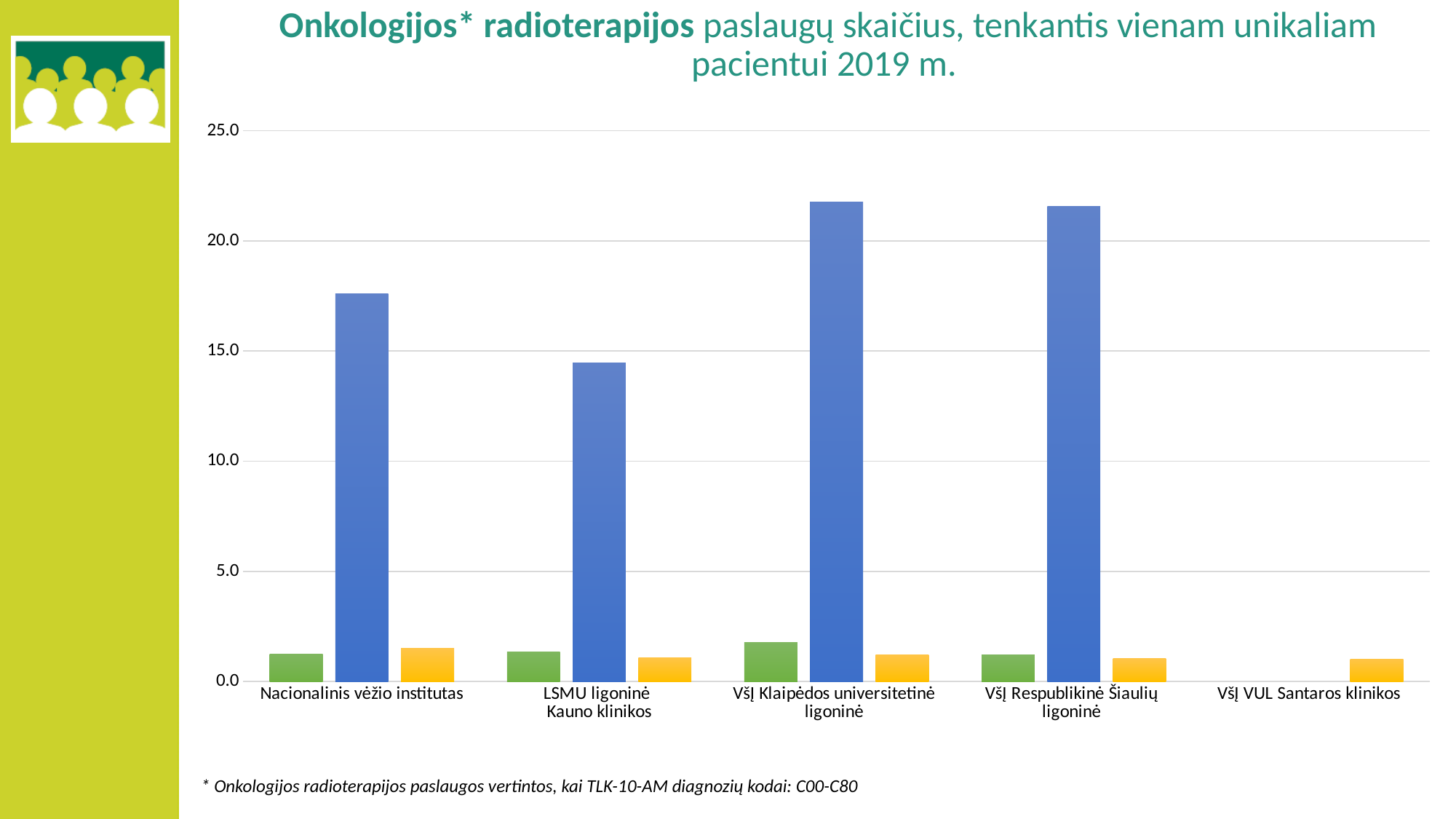
Which year does the chart title refer to? 2019 m. Is the value of the blue bar for VšĮ Respublikinė Šiaulių ligoninė greater or less than 20.0? greater Which has the larger blue bar: Nacionalinis vėžio institutas or LSMU ligoninė Kauno klinikos? Nacionalinis vėžio institutas Is the value of the blue bar for VšĮ Klaipėdos universitetinė ligoninė greater or less than 20.0? greater Which hospital has the lowest blue bar among those with a visible blue bar? LSMU ligoninė Kauno klinikos Is the value of the blue bar for LSMU ligoninė Kauno klinikos greater or less than 15.0? less What kind of chart is shown on the slide? bar chart Which has the larger blue bar: VšĮ Klaipėdos universitetinė ligoninė or LSMU ligoninė Kauno klinikos? VšĮ Klaipėdos universitetinė ligoninė Which hospital has the highest green bar? VšĮ Klaipėdos universitetinė ligoninė How many hospitals (categories) are shown on the x axis? 5